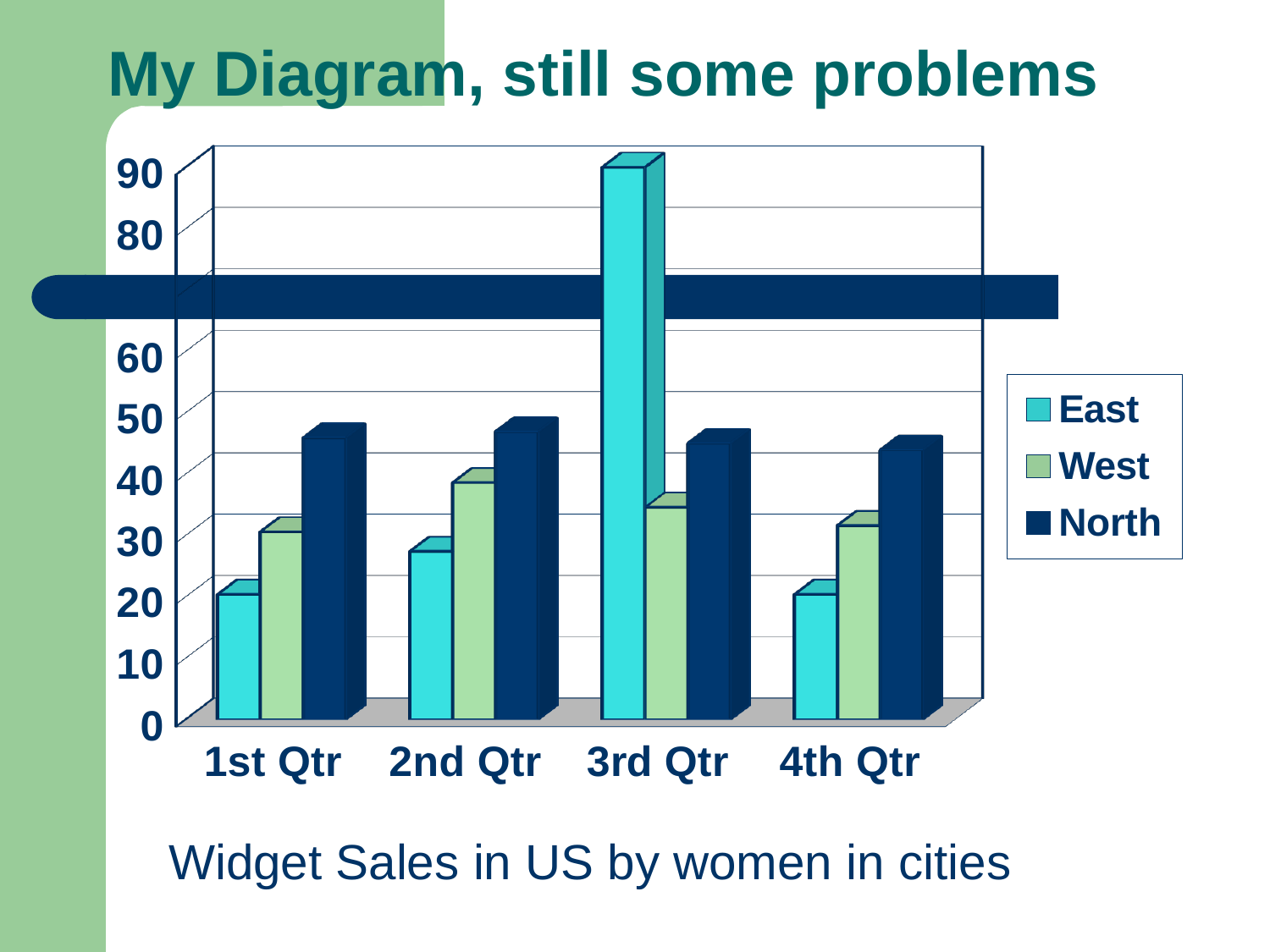
Is the East value for 3rd Qtr greater or less than 80? greater Is the East value for 1st Qtr greater or less than 30? less How many series does the legend list? 3 Is the North value for 1st Qtr greater or less than 50? less In which quarter is the West value highest? 2nd Qtr How many quarters are shown on the x axis? 4 What caption appears below the chart? Widget Sales in US by women in cities In 3rd Qtr, which is larger, the East value or the West value? East What kind of chart is shown on the slide? bar chart In 1st Qtr, which is larger, the North value or the East value? North In which quarter is the East value highest? 3rd Qtr